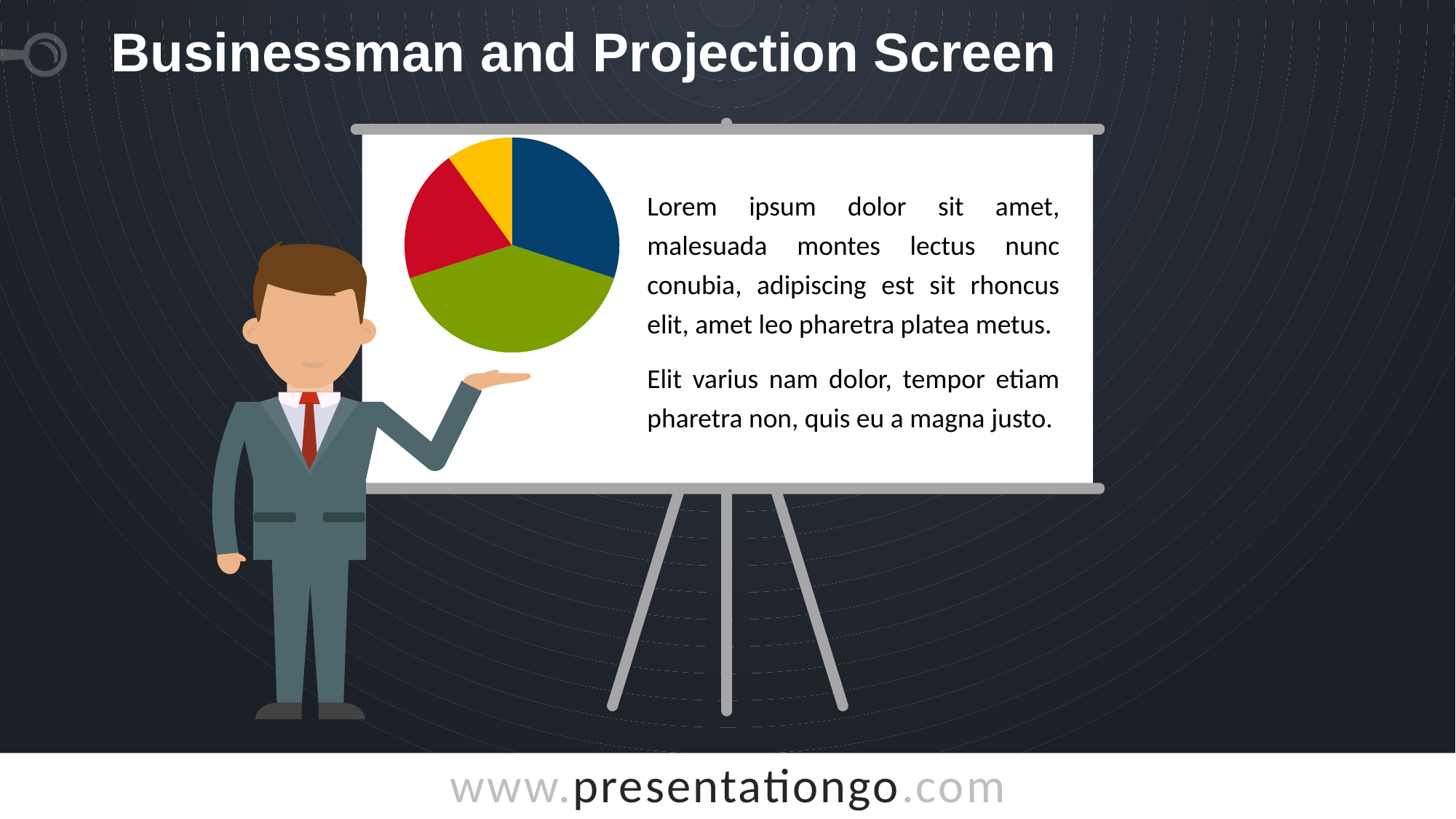
In the pie chart, is the blue slice or the yellow slice larger? blue Does the pie chart on the slide have a legend? No What kind of chart is shown on the projection screen? pie chart Which colour slice is the largest in the pie chart? green How many slices does the pie chart on the projection screen have? 4 Which colour slice is the smallest in the pie chart? yellow In the pie chart, is the green slice or the yellow slice larger? green What colours are the slices of the pie chart? blue, green, red, yellow